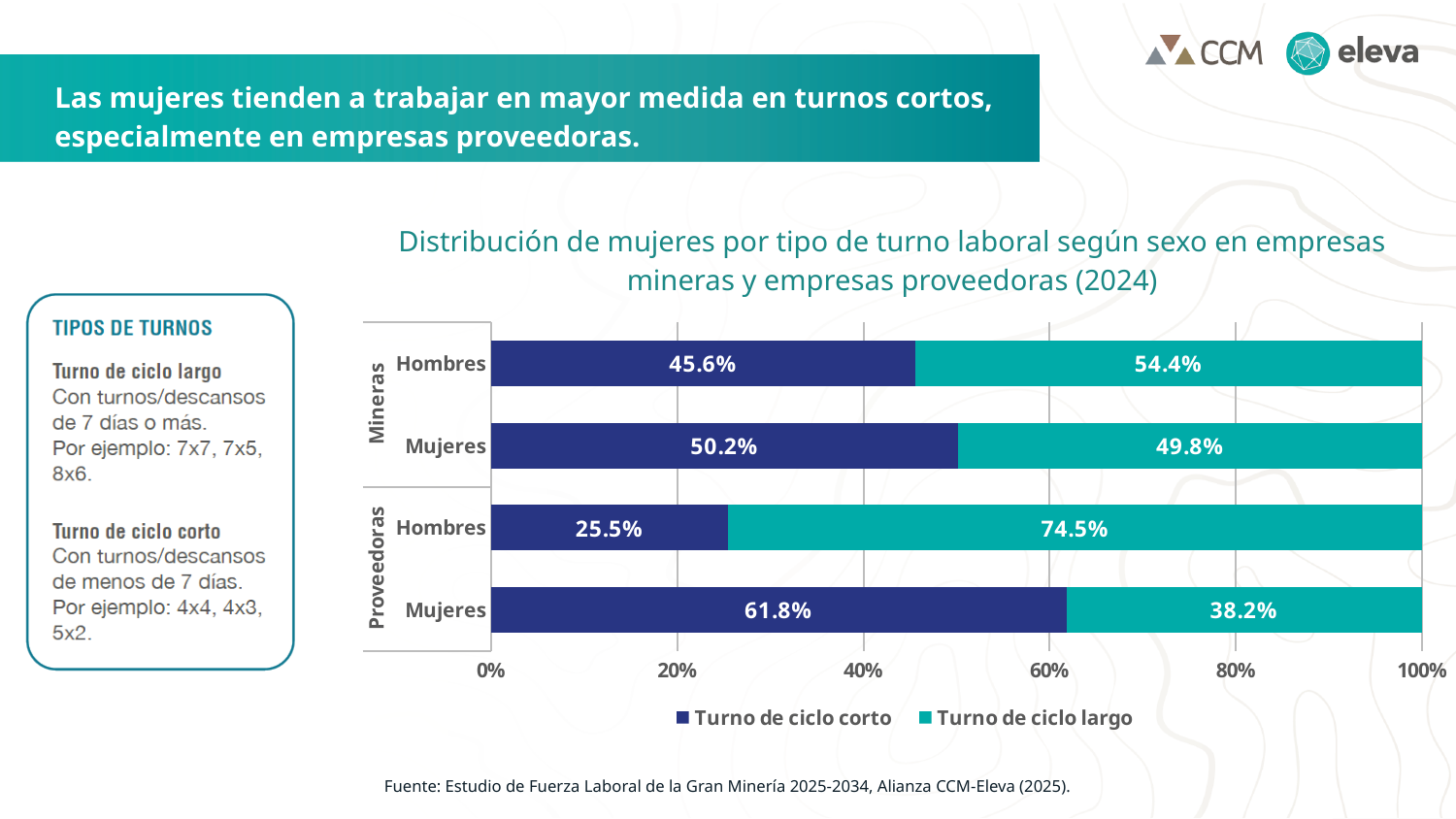
What percentage of women in mining companies (Mineras, Mujeres) work a short-cycle shift (Turno de ciclo corto)? 50.2% How many bars are shown in the chart? 4 What is the difference in Turno de ciclo corto share between women and men in supplier companies (Proveedoras)? 36.3 percentage points How many series does the legend list? 2 What kind of chart is shown on the slide? Stacked horizontal bar chart Which group has the highest share of Turno de ciclo corto? Proveedoras, Mujeres What is the title of the chart? Distribución de mujeres por tipo de turno laboral según sexo en empresas mineras y empresas proveedoras (2024) Which is larger: the Turno de ciclo corto share for women in mining companies or for men in mining companies? Women in mining companies (50.2%) What percentage of men in supplier companies (Proveedoras, Hombres) work a long-cycle shift (Turno de ciclo largo)? 74.5% What is the Turno de ciclo corto value for women in supplier companies (Proveedoras, Mujeres)? 61.8% What is the Turno de ciclo largo value for men in mining companies (Mineras, Hombres)? 54.4% Which group has the lowest share of Turno de ciclo corto? Proveedoras, Hombres